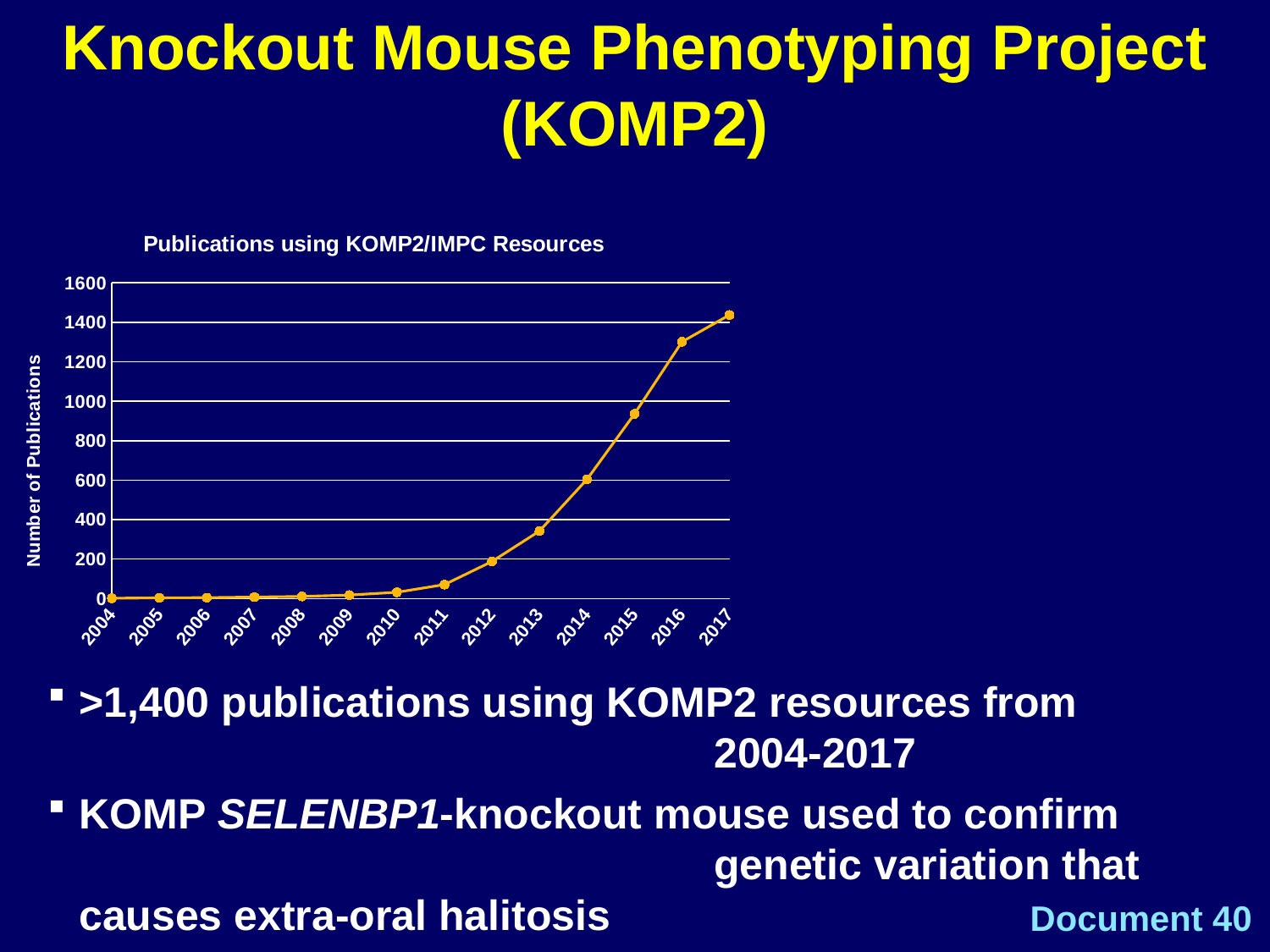
Do the values generally rise or fall from 2004 to 2017? rise Is the value for 2016 greater or less than 1200? greater What is the label on the vertical axis of the chart? Number of Publications Is the value for 2013 greater or less than 400? less What kind of chart is shown on the slide? line chart What is the title of the chart? Publications using KOMP2/IMPC Resources Is the value for 2015 greater or less than 1000? less How many years are plotted along the x axis of the chart? 14 Which year has the larger number of publications, 2014 or 2016? 2016 Which year has the highest number of publications? 2017